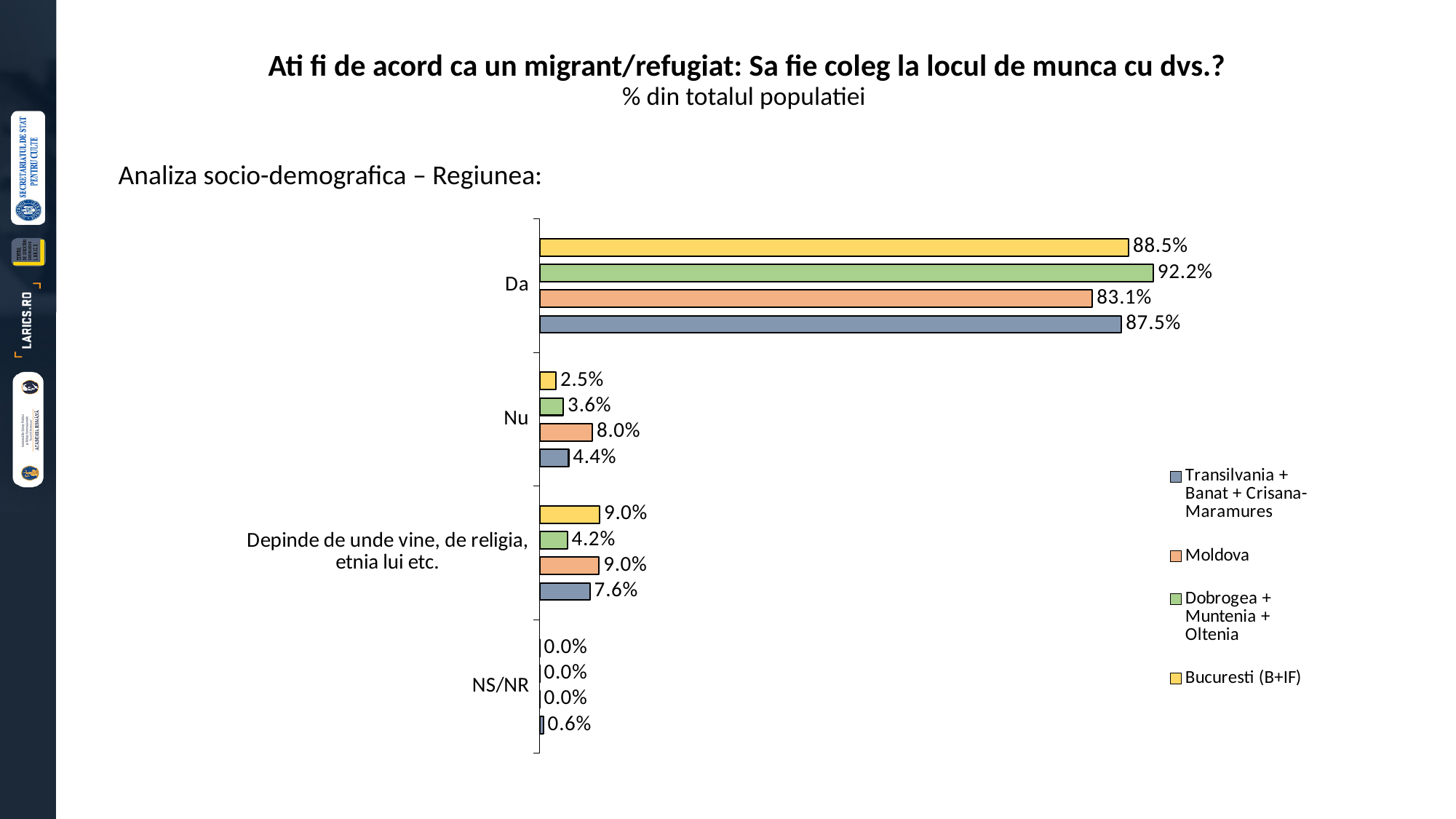
What is the value for Bucuresti (B+IF) in the 'Nu' category? 2.5% What is the subtitle shown under the chart title? % din totalul populatiei What is the difference between the 'Da' values for Dobrogea + Muntenia + Oltenia and Moldova? 9.1% Which region has the lowest value in the 'Nu' category? Bucuresti (B+IF) Which region has the highest value in the 'Da' category? Dobrogea + Muntenia + Oltenia How many response categories are shown on the chart? 4 How many series does the legend list? 4 What is the value for Dobrogea + Muntenia + Oltenia in the 'Da' category? 92.2% What is the value for Transilvania + Banat + Crisana-Maramures in the 'NS/NR' category? 0.6% What is the value for Moldova in the 'Da' category? 83.1% What kind of chart is shown on the slide? bar chart In the 'Depinde de unde vine, de religia, etnia lui etc.' category, which is larger: the value for Transilvania + Banat + Crisana-Maramures or for Dobrogea + Muntenia + Oltenia? Transilvania + Banat + Crisana-Maramures